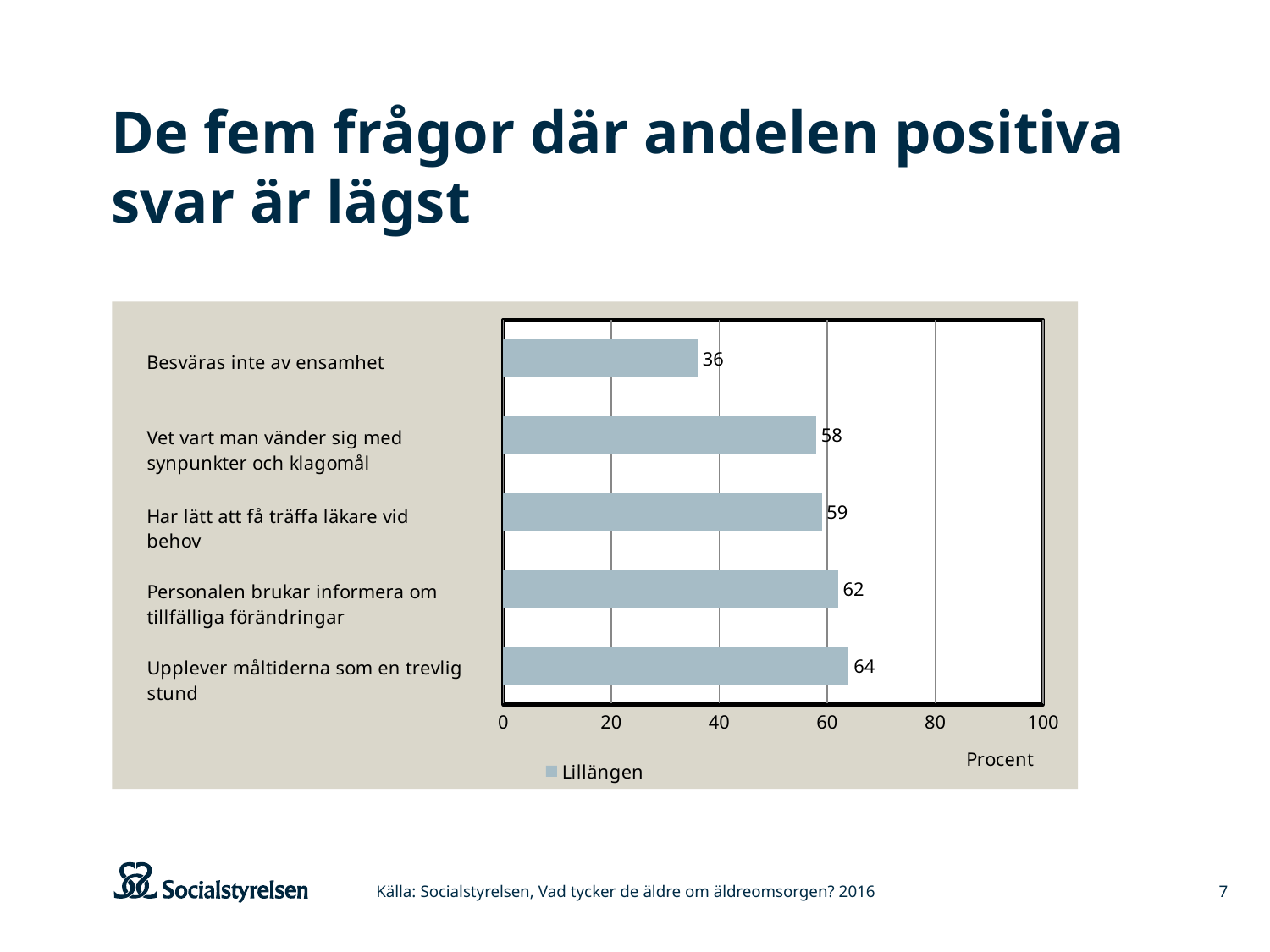
What is the value for "Personalen brukar informera om tillfälliga förändringar"? 62 How many categories are shown in the chart? 5 What series name does the legend show? Lillängen Which is larger: the value for "Vet vart man vänder sig med synpunkter och klagomål" or the value for "Personalen brukar informera om tillfälliga förändringar"? Personalen brukar informera om tillfälliga förändringar Which category has the lowest value? Besväras inte av ensamhet What kind of chart is shown on the slide? bar chart What is the value for "Besväras inte av ensamhet"? 36 Which category has the highest value? Upplever måltiderna som en trevlig stund What is the difference between the values for "Upplever måltiderna som en trevlig stund" and "Besväras inte av ensamhet"? 28 Is the value for "Besväras inte av ensamhet" greater or less than 40? less What is the value for "Har lätt att få träffa läkare vid behov"? 59 What is the value for "Upplever måltiderna som en trevlig stund"? 64